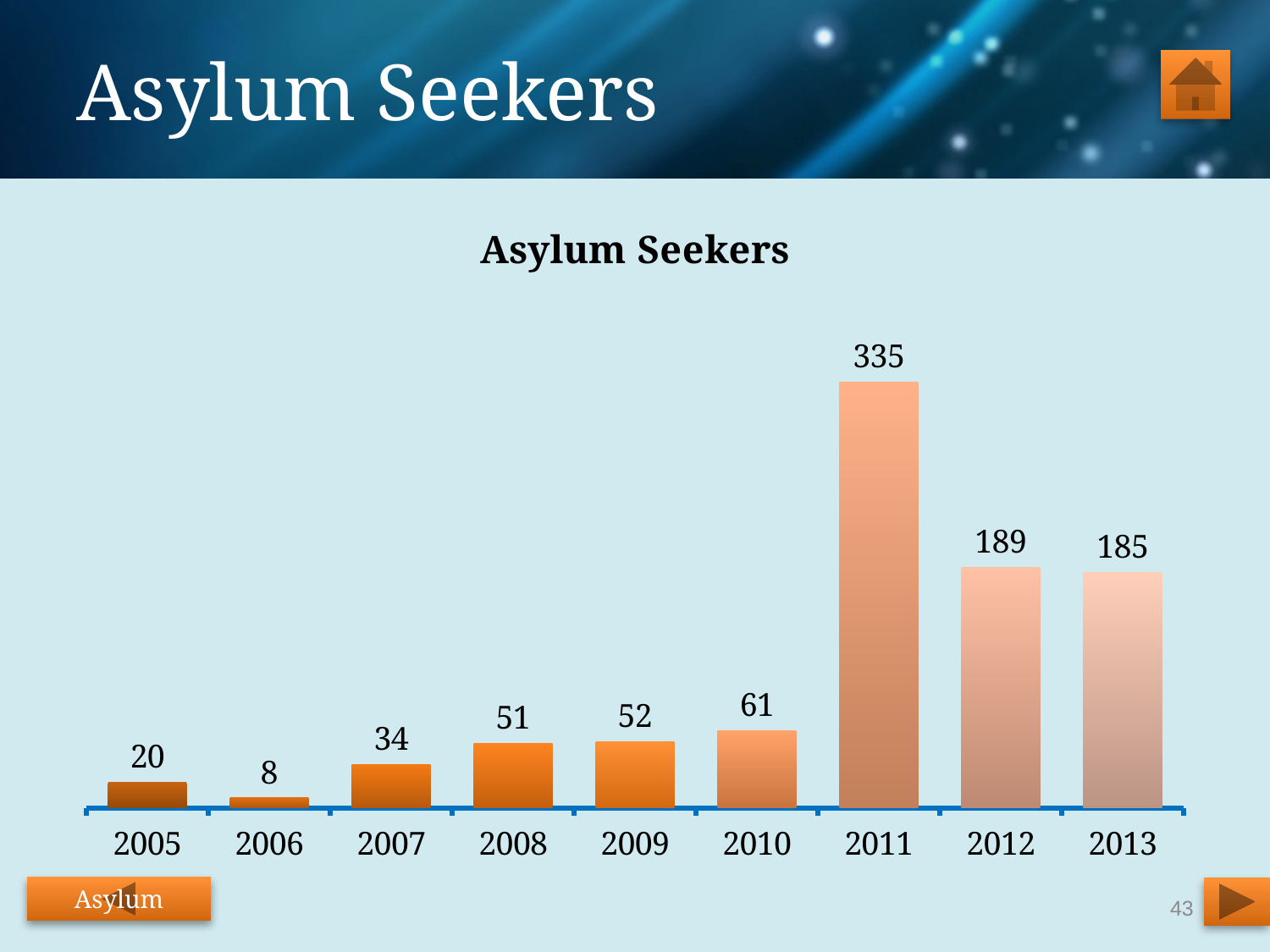
Which is larger, the value for 2005 or the value for 2007? 2007 What is the value for 2013? 185 What is the value for 2011? 335 What is the difference between the values for 2011 and 2012? 146 What is the value for 2006? 8 How many years are shown on the chart? 9 What is the difference between the values for 2010 and 2009? 9 What is the title of the chart? Asylum Seekers What kind of chart is shown? bar chart Which year has the lowest value? 2006 Which is larger, the value for 2012 or the value for 2013? 2012 Which year has the highest value? 2011